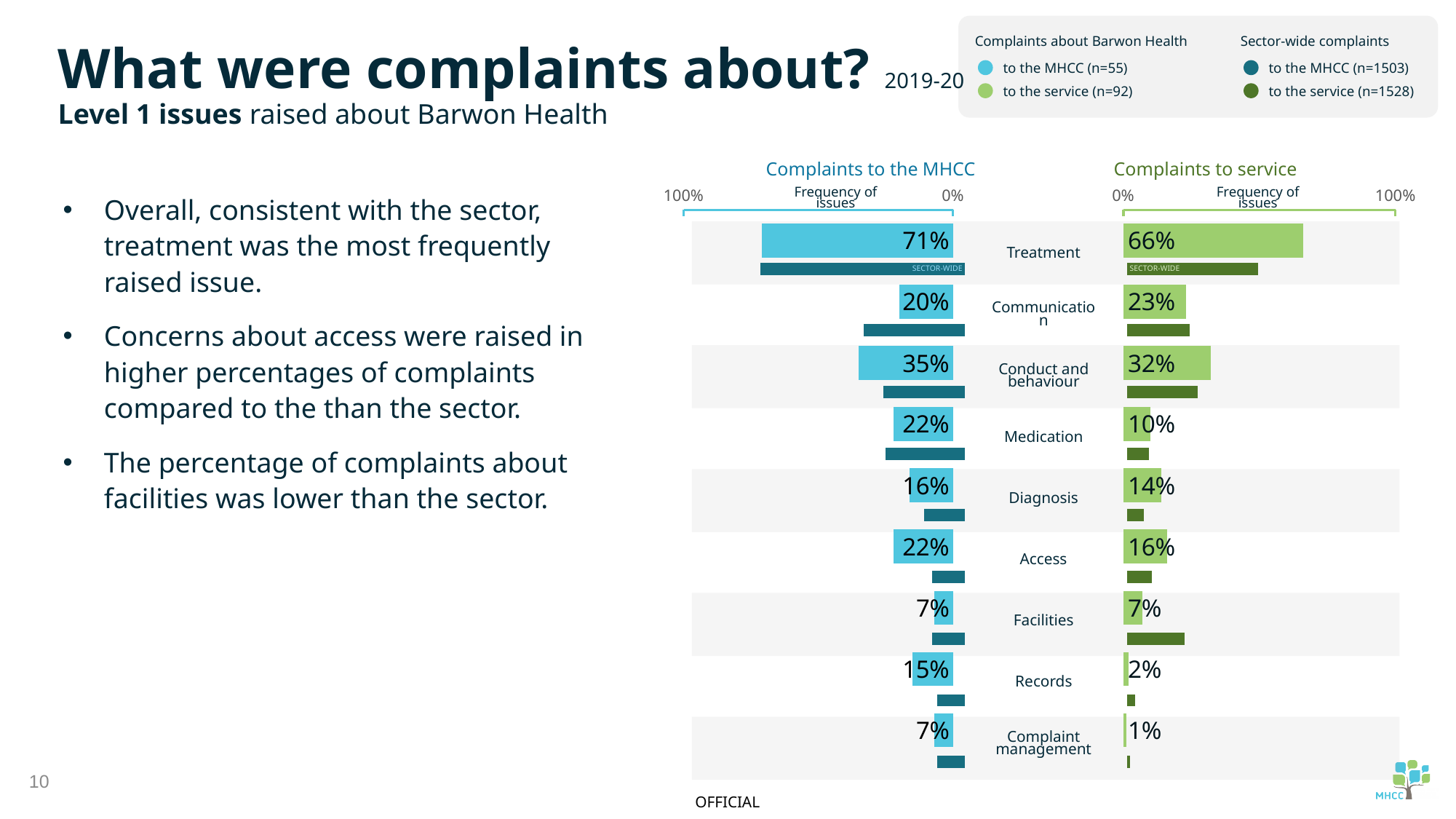
In the 'Complaints to service' chart, what is the Barwon Health value for Records? 2% In the 'Complaints to service' chart, what percentage of Barwon Health complaints raised Conduct and behaviour? 32% In the 'Complaints to the MHCC' chart, which issue has the highest Barwon Health percentage? Treatment In the 'Complaints to the MHCC' chart, what is the difference between the Barwon Health values for Treatment and Conduct and behaviour? 36% Is the Barwon Health value for Medication larger in the 'Complaints to the MHCC' chart or the 'Complaints to service' chart? Complaints to the MHCC In the 'Complaints to service' chart, which issue has the lowest Barwon Health percentage? Complaint management In the 'Complaints to the MHCC' chart, is the Barwon Health value for Access greater or less than the value for Diagnosis? greater In the 'Complaints to service' chart, what is the difference between the Barwon Health values for Treatment and Communication? 43% What type of chart is used to show the frequency of issues? Bar chart In the 'Complaints to the MHCC' chart, what percentage of Barwon Health complaints raised Treatment? 71% According to the legend, how many complaints about Barwon Health were made to the MHCC? n=55 How many issue categories are listed in the charts? 9